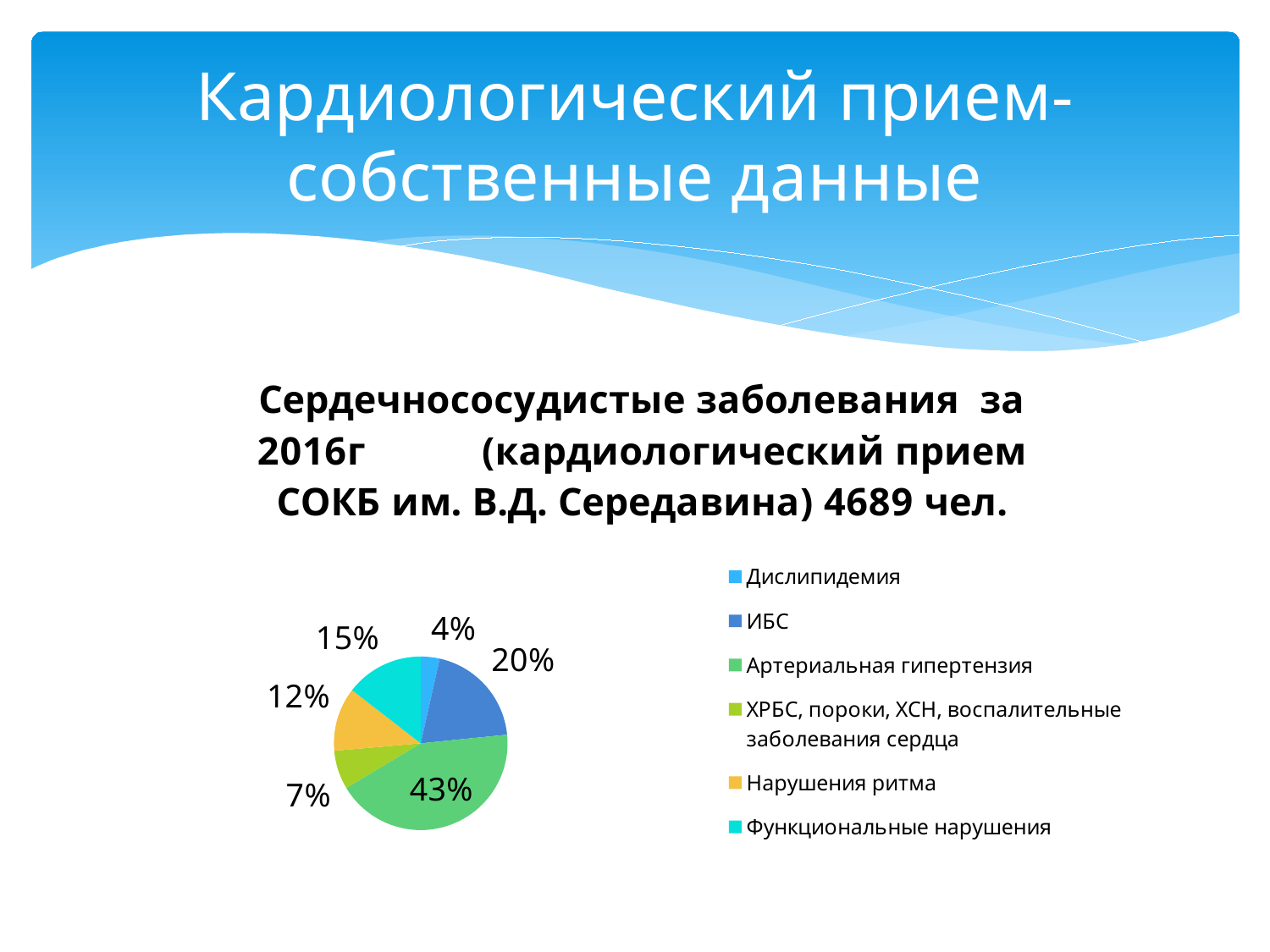
How many categories does the pie chart have? 6 Which category has the smallest slice of the pie? Дислипидемия What share of the pie does Артериальная гипертензия account for? 43% Which is larger, the share for Нарушения ритма or the share for ХРБС, пороки, ХСН, воспалительные заболевания сердца? Нарушения ритма What is the difference in percentage points between Артериальная гипертензия and ИБС? 23 What type of chart is shown on the slide? pie chart According to the chart title, how many people does the data cover? 4689 чел. What percentage is shown for Функциональные нарушения? 15% Which category has the largest slice of the pie? Артериальная гипертензия What is the value shown for ИБС? 20% What is the value for Дислипидемия? 4% What percentage is shown for Нарушения ритма? 12%